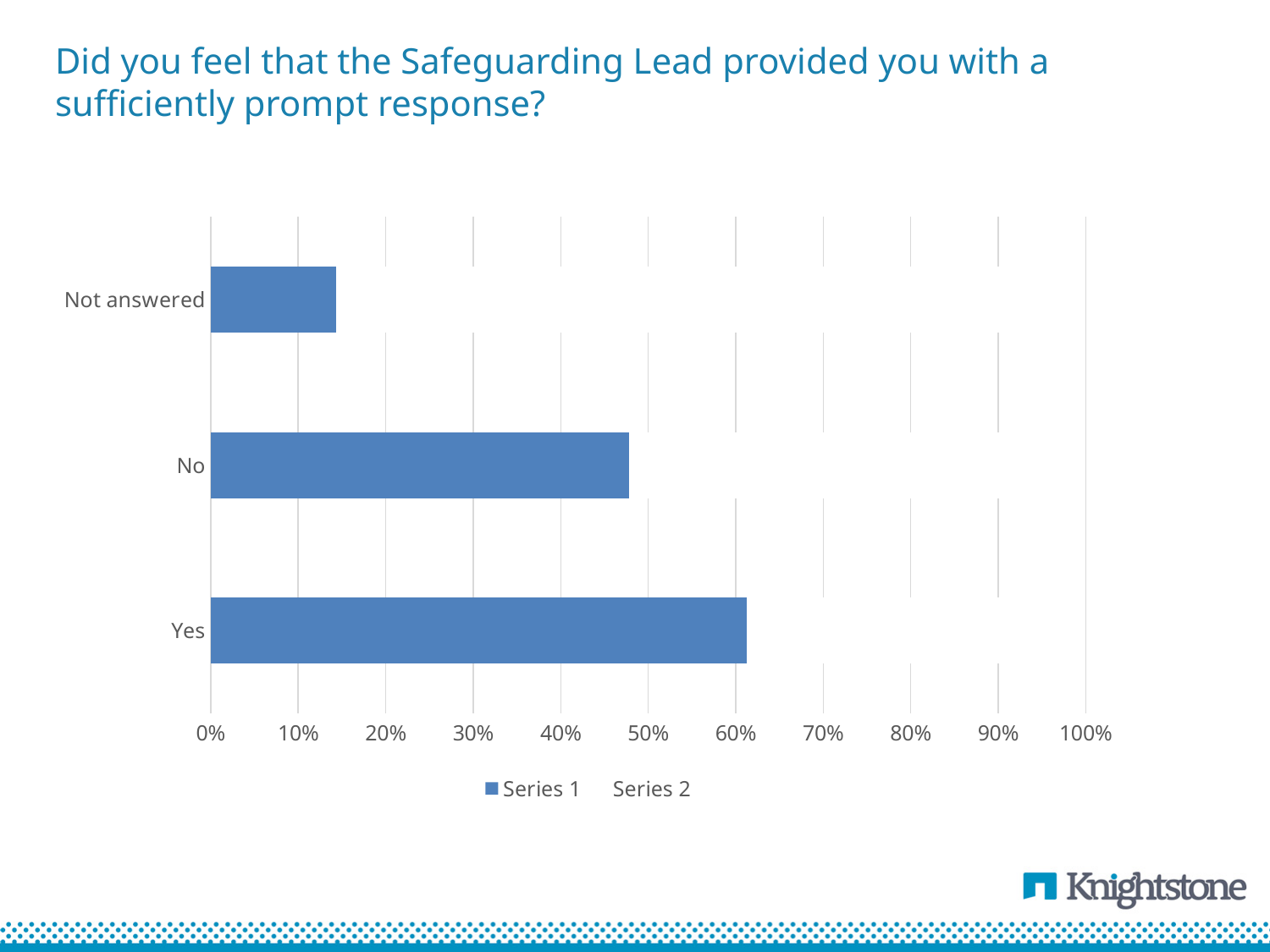
Is the value for Not answered greater or less than 20%? less What is the highest value shown on the horizontal axis? 100% Which category has the lowest value? Not answered Is the value for Yes greater or less than 50%? greater Which is larger, the value for Yes or the value for No? Yes Which is larger, the value for No or the value for Not answered? No How many categories are plotted on the chart? 3 How many series does the legend list? 2 What is the title of the chart? Did you feel that the Safeguarding Lead provided you with a sufficiently prompt response? Is the value for No greater or less than 40%? greater What kind of chart is shown on the slide? Bar chart Which category has the highest value? Yes